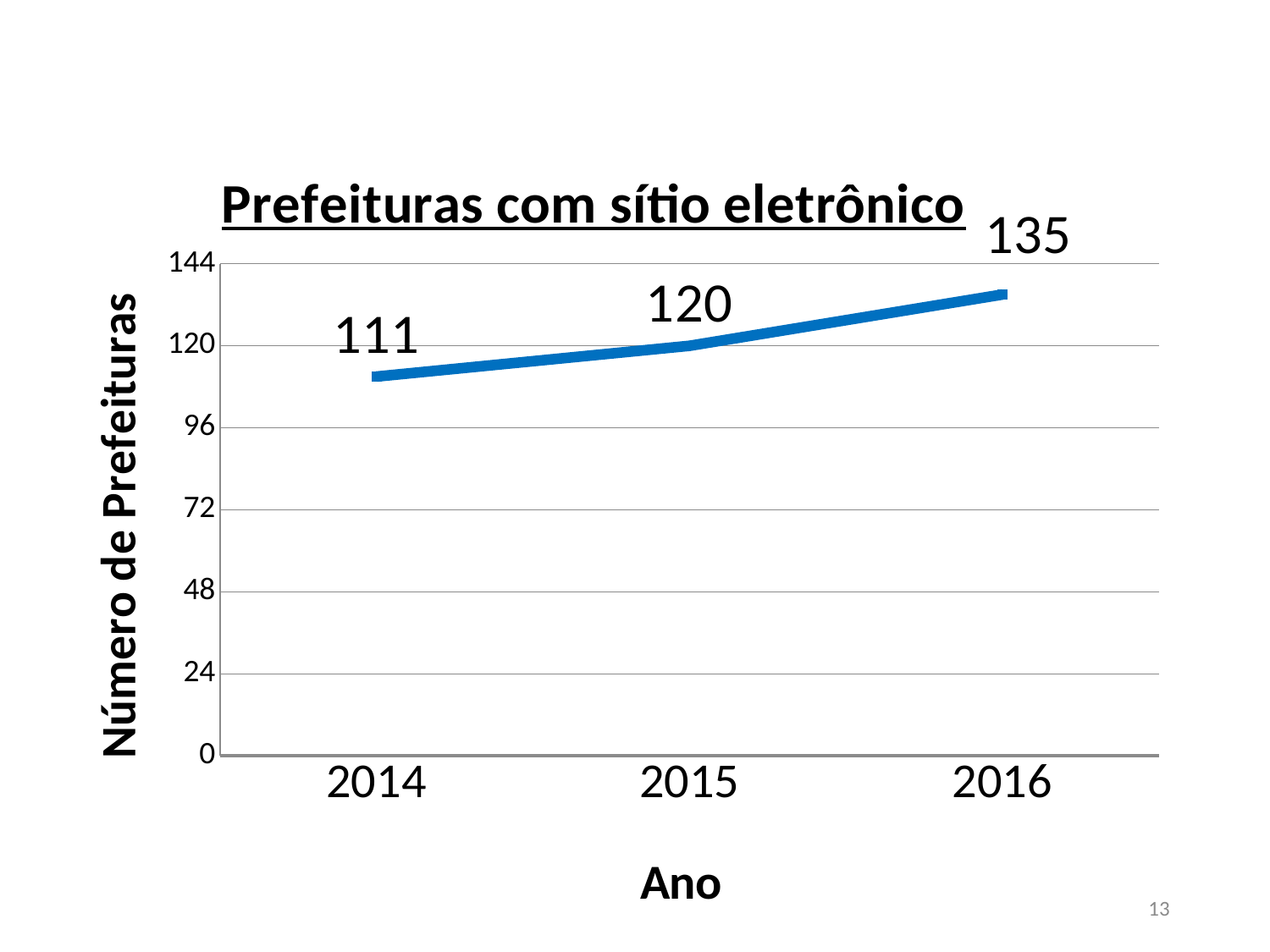
What is the value for 2015? 120 What is the value for 2014? 111 Which is larger, the value for 2015 or the value for 2016? 2016 What is the difference between the values for 2016 and 2014? 24 What kind of chart is shown? line chart Which year has the highest number of prefeituras? 2016 Do the values rise or fall from 2014 to 2016? rise Is the value for 2016 greater or less than 120? greater Which year has the lowest number of prefeituras? 2014 What is the difference between the values for 2015 and 2014? 9 How many years are plotted on the x axis? 3 What is the value for 2016? 135